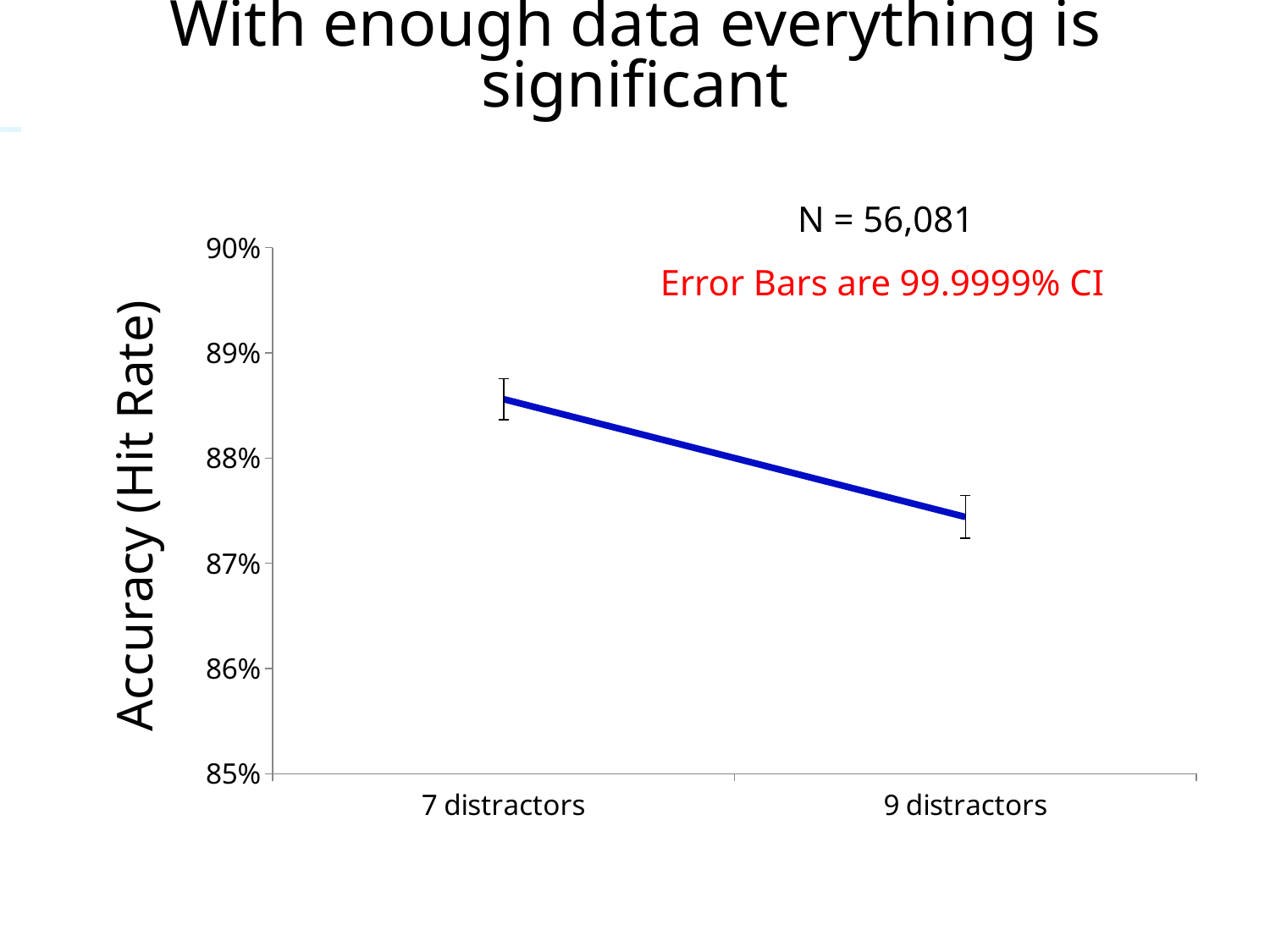
What is the label of the y axis? Accuracy (Hit Rate) Which category has the highest accuracy (hit rate)? 7 distractors What sample size (N) is stated on the slide? N = 56,081 What kind of chart is shown on the slide? line chart Which category has the lowest accuracy (hit rate)? 9 distractors How many categories are plotted along the x axis? 2 Is the accuracy for 9 distractors greater or less than 88%? less Do the accuracy values rise or fall from 7 distractors to 9 distractors? fall Is the accuracy for 7 distractors greater or less than 88%? greater Is the accuracy for 7 distractors greater or less than 89%? less Which is larger, the accuracy for 7 distractors or for 9 distractors? 7 distractors